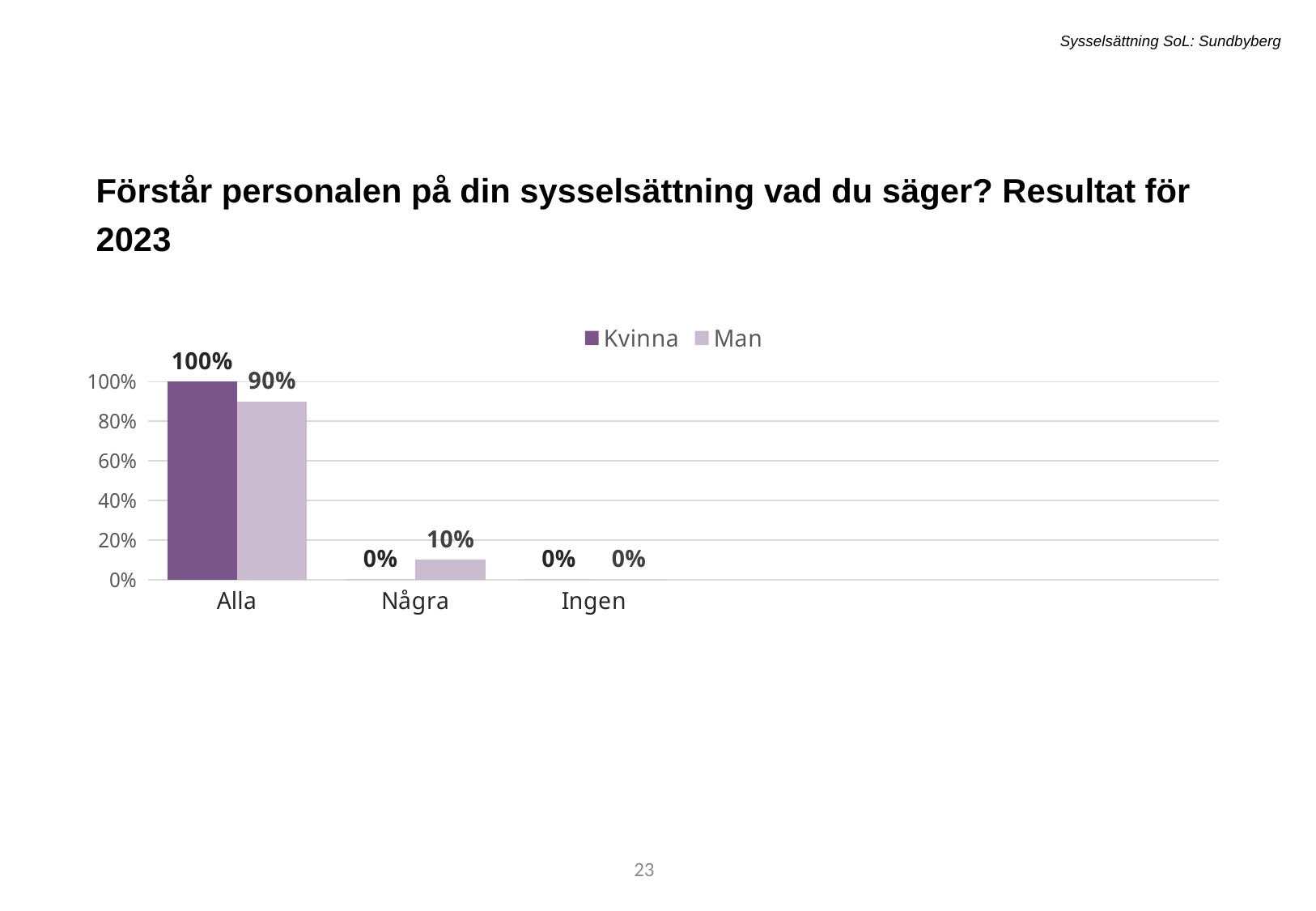
What kind of chart is shown on the slide? Bar chart In the Alla category, which series has the larger value, Kvinna or Man? Kvinna Which category has the highest value for Man? Alla What is the value for Kvinna in the Några category? 0% How many categories are shown on the x axis? 3 What is the difference between the Man values for Alla and Några? 80% What is the value for Man in the Några category? 10% Which series is shown in the darker purple colour? Kvinna What is the value for Man in the Alla category? 90% What is the difference between the Kvinna and Man values in the Alla category? 10% How many series does the legend list? 2 What is the value for Kvinna in the Alla category? 100%